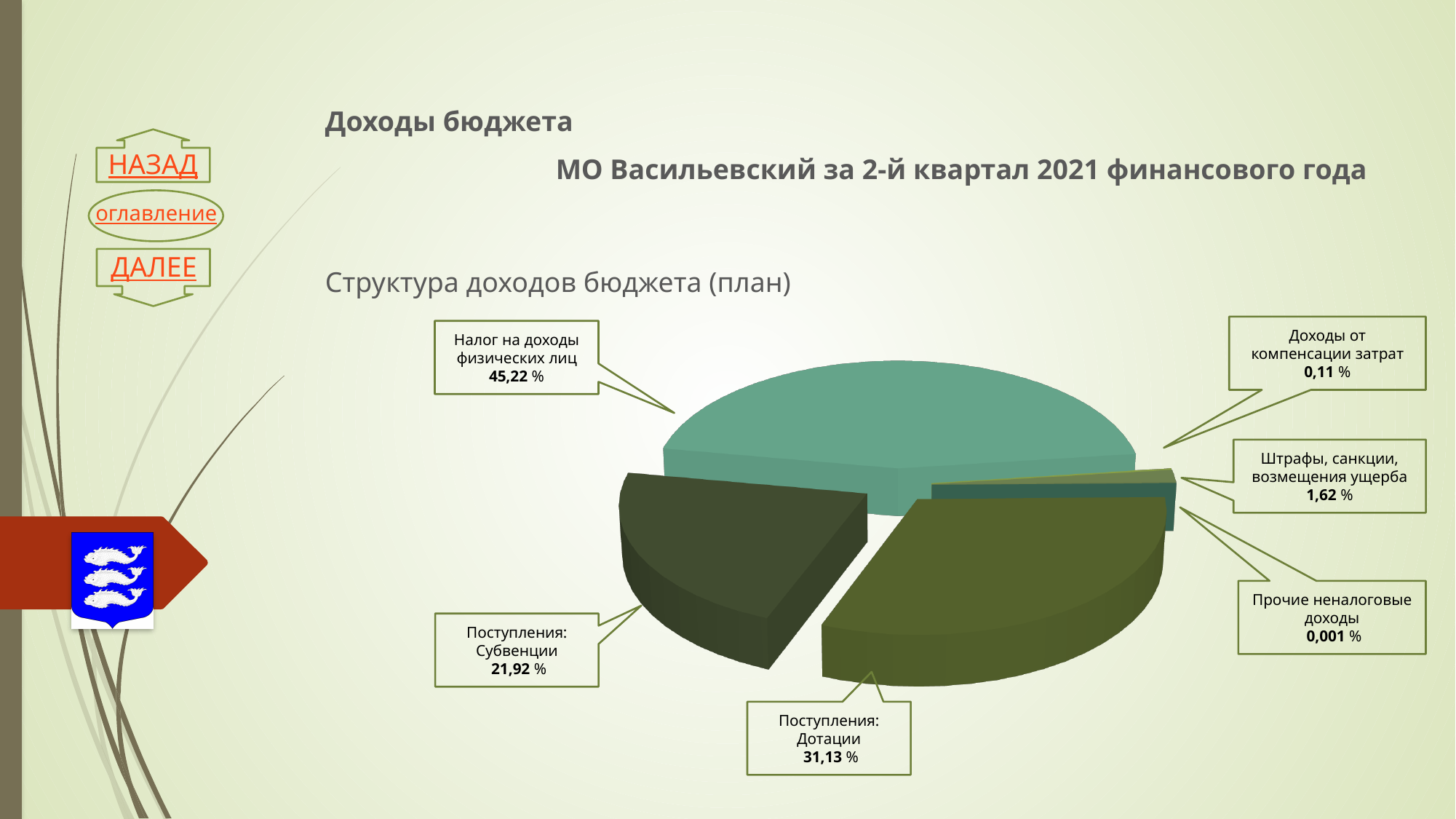
Which category has the smallest share of the pie? Прочие неналоговые доходы What is the difference between the shares of "Налог на доходы физических лиц" and "Поступления: Дотации"? 14,09 % What is the value shown for "Поступления: Субвенции"? 21,92 % What type of chart is shown on the slide? Pie chart What is the difference between the shares of "Поступления: Дотации" and "Поступления: Субвенции"? 9,21 % Which category has the largest share of the pie? Налог на доходы физических лиц What share of the pie does "Налог на доходы физических лиц" have? 45,22 % What is the value shown for "Прочие неналоговые доходы"? 0,001 % What is the value shown for "Поступления: Дотации"? 31,13 % Which is larger: the share of "Штрафы, санкции, возмещения ущерба" or "Доходы от компенсации затрат"? Штрафы, санкции, возмещения ущерба What is the value shown for "Штрафы, санкции, возмещения ущерба"? 1,62 % How many slices does the pie chart have? 6